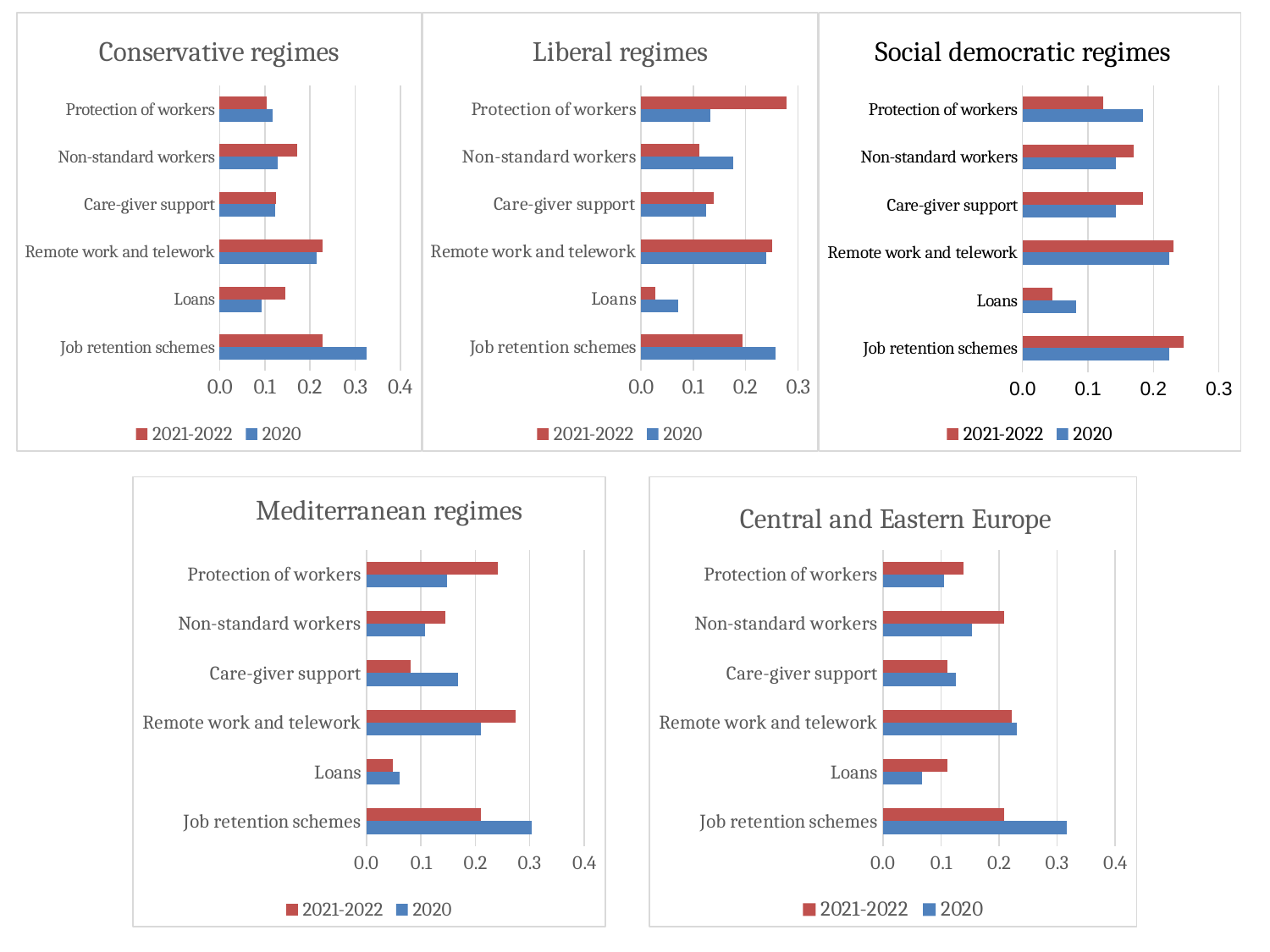
How many categories are shown in the Liberal regimes chart? 6 How many series does the legend of the Conservative regimes chart list? 2 In the Liberal regimes chart, which is larger for Protection of workers: the 2021-2022 value or the 2020 value? 2021-2022 In the Central and Eastern Europe chart, is the 2020 value for Job retention schemes greater or less than 0.3? greater In the Social democratic regimes chart, is the 2021-2022 value for Loans greater or less than 0.1? less In the Mediterranean regimes chart, which category has the highest value for 2020? Job retention schemes In the Conservative regimes chart, is the 2020 value for Job retention schemes greater or less than 0.3? greater In the Conservative regimes chart, which category has the highest value for 2020? Job retention schemes In the Liberal regimes chart, which category has the lowest value for 2021-2022? Loans In the Central and Eastern Europe chart, which category has the lowest value for 2020? Loans In the Social democratic regimes chart, which is larger for Protection of workers: the 2021-2022 value or the 2020 value? 2020